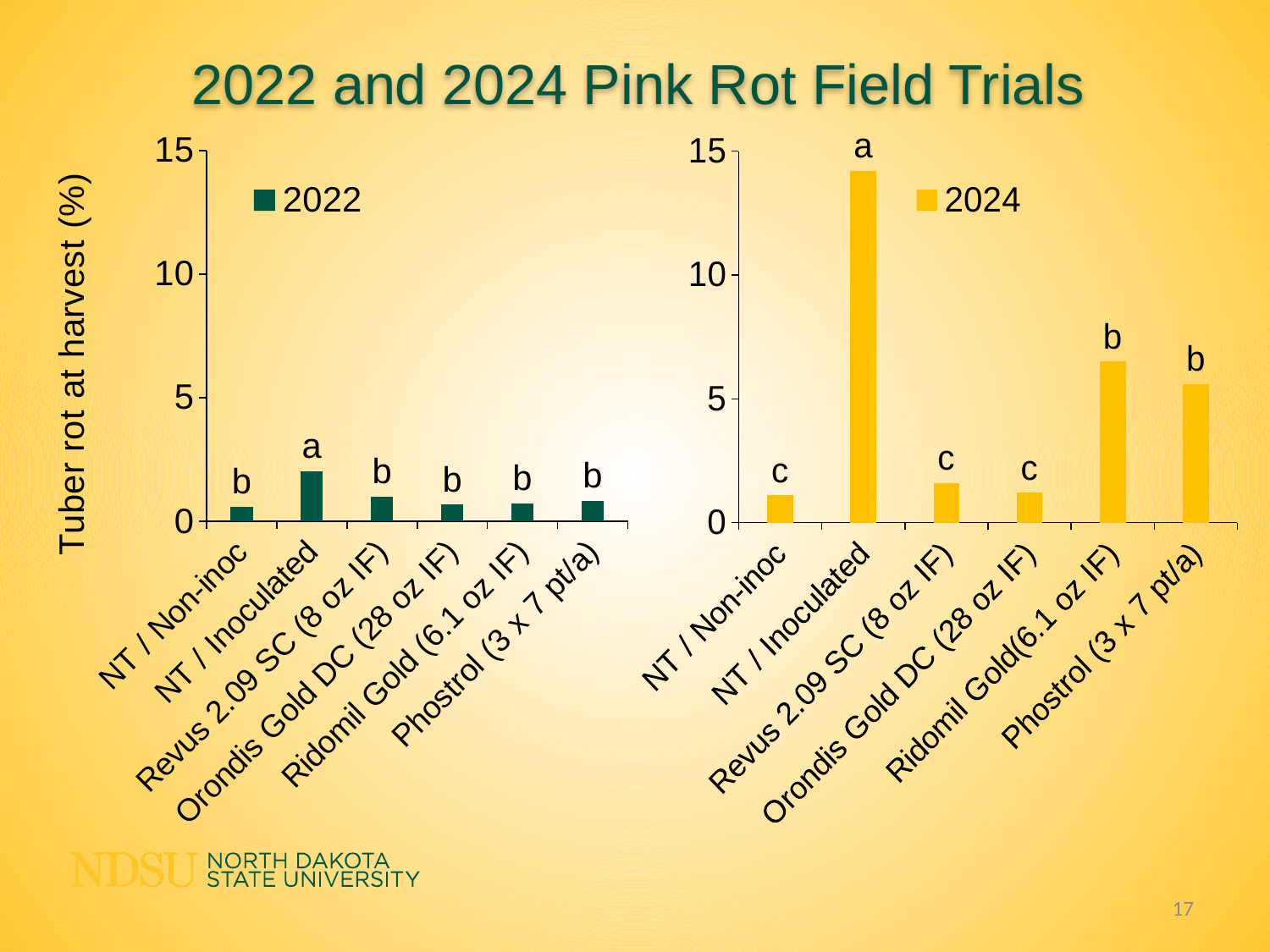
In the right chart (2024), is the value for NT / Inoculated greater or less than 10? greater In the left chart (2022), which category has the highest tuber rot at harvest? NT / Inoculated How many categories are shown on the x axis of the right chart (2024)? 6 In the right chart (2024), which category has the highest tuber rot at harvest? NT / Inoculated What is the y-axis title of the left chart? Tuber rot at harvest (%) In the left chart (2022), is the value for NT / Inoculated greater or less than 5? less What series name does the legend of the right chart show? 2024 What kind of chart is the left chart (2022)? bar chart How many series does the legend of the left chart list? 1 In the right chart (2024), which is larger, the value for Ridomil Gold (6.1 oz IF) or the value for Revus 2.09 SC (8 oz IF)? Ridomil Gold (6.1 oz IF) In the right chart (2024), is the value for Revus 2.09 SC (8 oz IF) greater or less than 5? less